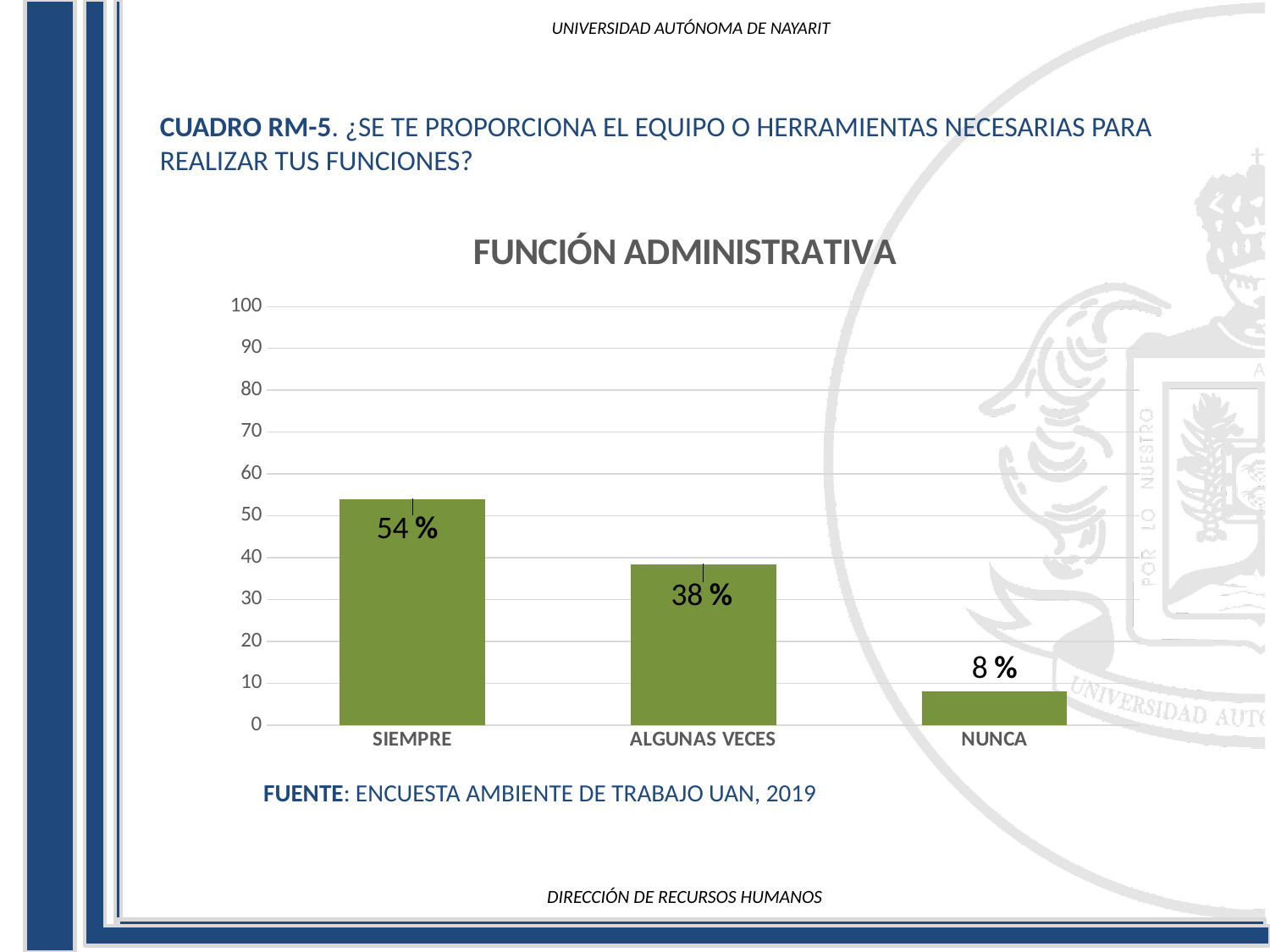
What is the title of the chart? FUNCIÓN ADMINISTRATIVA What is the difference between the values for ALGUNAS VECES and NUNCA? 30 % Is the value for SIEMPRE greater or less than 50? greater Which category has the lowest value? NUNCA What is the value for NUNCA? 8 % What is the difference between the values for SIEMPRE and ALGUNAS VECES? 16 % What is the value for SIEMPRE? 54 % What kind of chart is shown on the slide? bar chart How many categories are shown on the x axis? 3 Which category has the highest value? SIEMPRE What is the value for ALGUNAS VECES? 38 % Which is larger, the value for ALGUNAS VECES or the value for NUNCA? ALGUNAS VECES